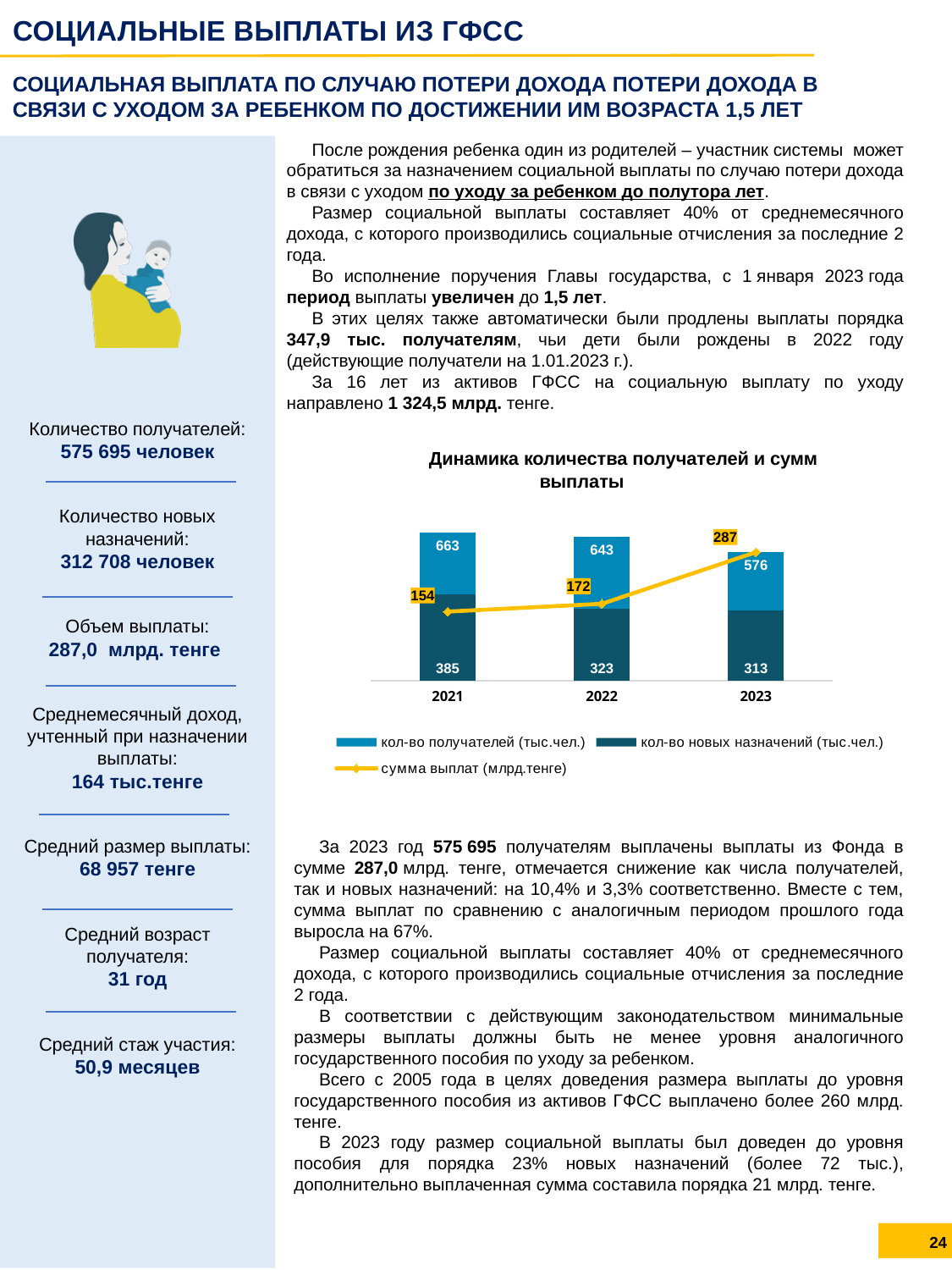
In which year is "сумма выплат (млрд.тенге)" the highest? 2023 What is the difference between "кол-во получателей (тыс.чел.)" in 2021 and in 2023? 87 What is the value of "кол-во получателей (тыс.чел.)" for 2021? 663 In which year is "кол-во новых назначений (тыс.чел.)" the lowest? 2023 What is the value of "кол-во новых назначений (тыс.чел.)" for 2022? 323 Which is larger: "сумма выплат (млрд.тенге)" in 2021 or in 2022? 2022 What type of chart is shown under the title "Динамика количества получателей и сумм выплаты"? A bar chart with a line What is the value of "сумма выплат (млрд.тенге)" for 2023? 287 How many years are shown on the x axis of the chart? 3 Does "кол-во получателей (тыс.чел.)" rise or fall from 2021 to 2023? Fall How many series does the chart legend list? 3 What is the value of "кол-во получателей (тыс.чел.)" for 2023? 576